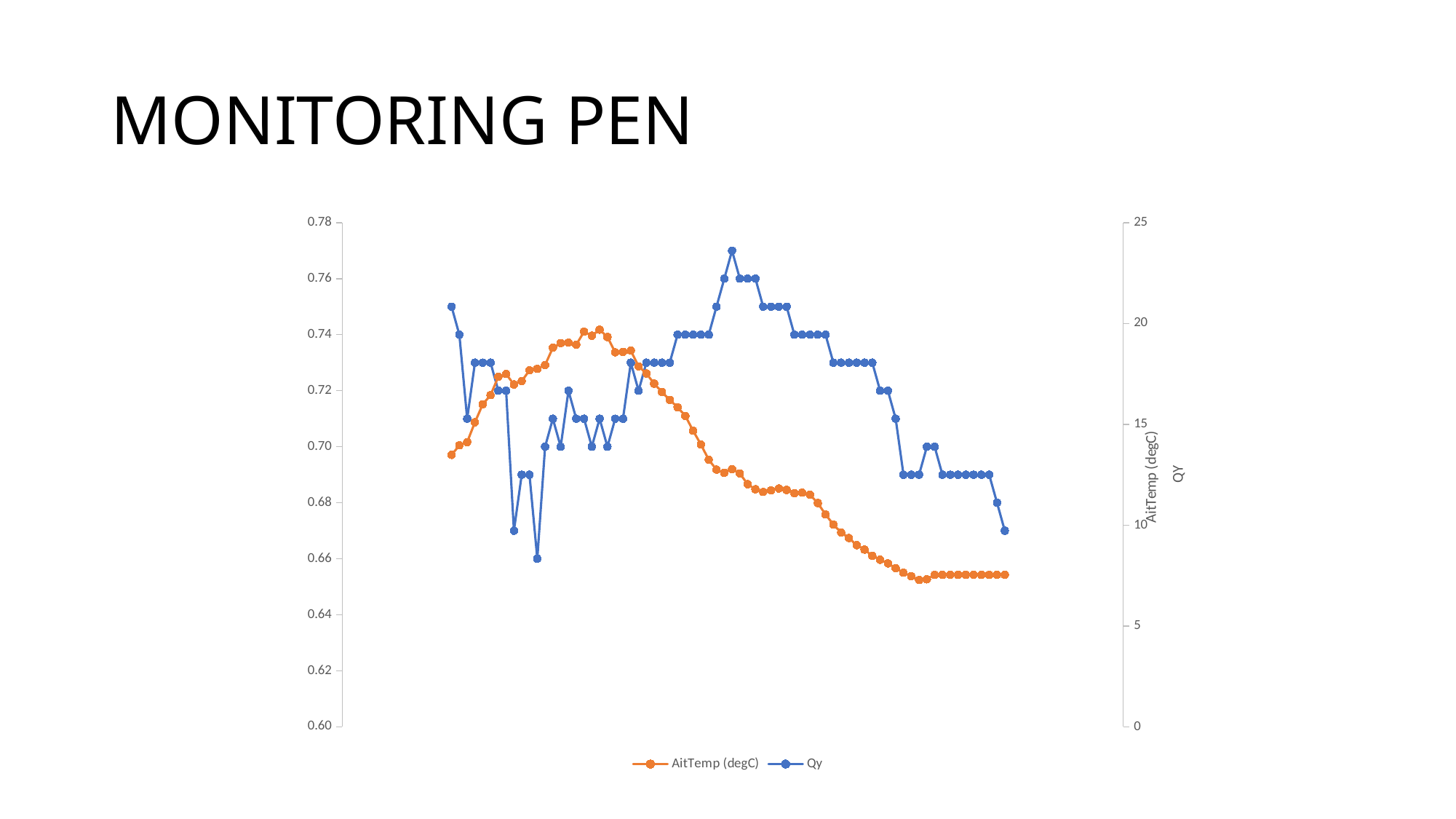
What kind of chart is shown on the slide? line chart Which series is drawn in orange? AitTemp (degC) Overall, does the Qy series rise or fall from its first point to its last point? fall Overall, does the AitTemp (degC) series rise or fall from its first point to its last point? fall How many series does the legend list? 2 Which series is drawn in blue? Qy After reaching its peak, does the Qy series mostly rise or fall toward the end of the chart? fall